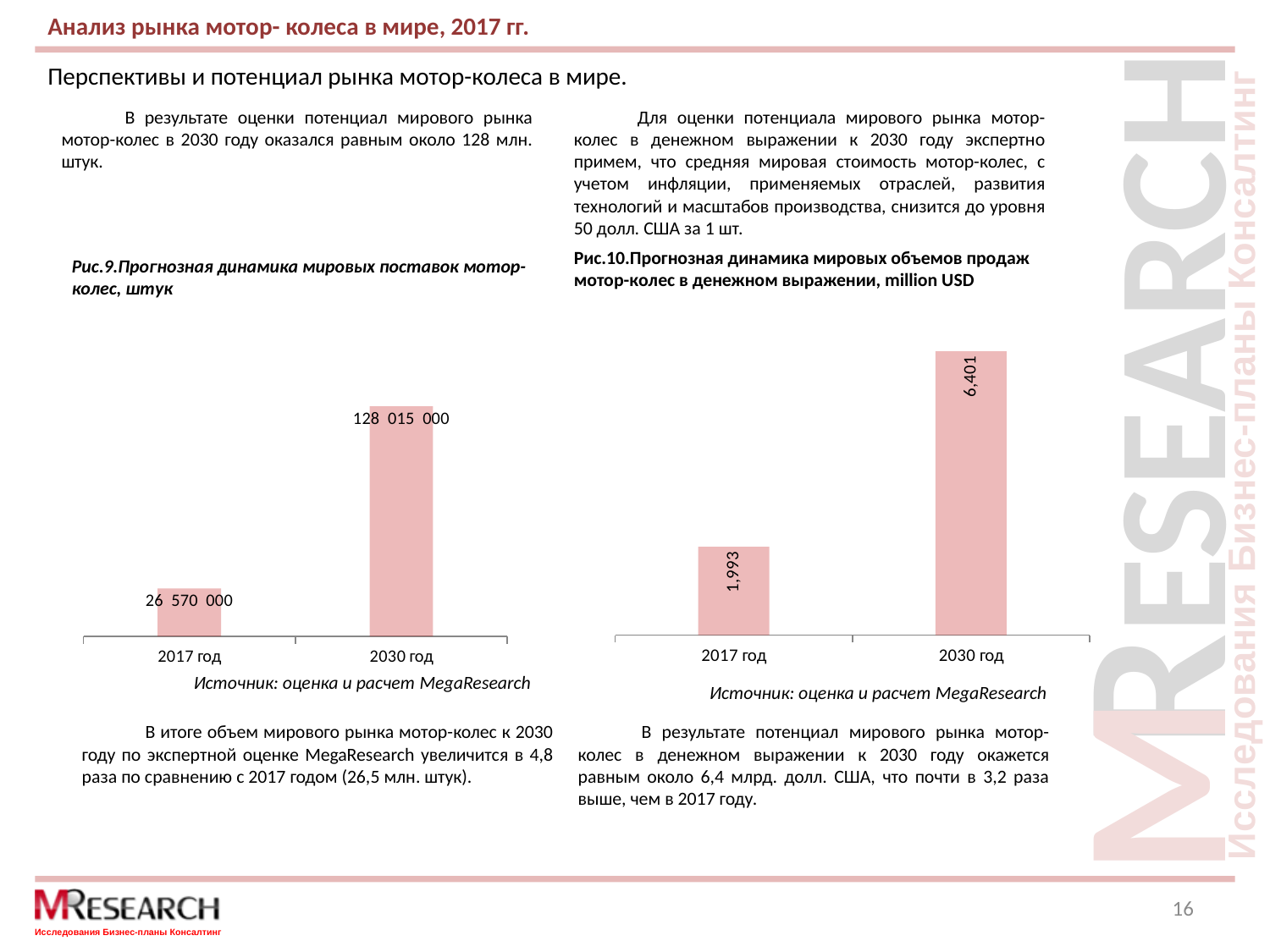
In the right chart (Рис.10, объемы продаж в денежном выражении, million USD), what is the value for 2030 год? 6,401 In the right chart (Рис.10, объемы продаж в денежном выражении, million USD), what is the value for 2017 год? 1,993 What type of chart is the right chart (Рис.10)? bar chart In the right chart (Рис.10), which year has the lower value? 2017 год In the left chart (Рис.9, мировые поставки мотор-колес, штук), what is the value for 2017 год? 26 570 000 In the left chart (Рис.9), which year has the higher value? 2030 год In the left chart (Рис.9), what is the difference between the 2030 год and 2017 год values? 101 445 000 How many categories (years) are shown in the left chart (Рис.9)? 2 In the right chart (Рис.10), what is the difference between the 2030 год and 2017 год values? 4,408 In the right chart (Рис.10), is the value for 2030 год larger or smaller than the value for 2017 год? larger In the left chart (Рис.9), do the values rise or fall from 2017 год to 2030 год? rise In the left chart (Рис.9, мировые поставки мотор-колес, штук), what is the value for 2030 год? 128 015 000